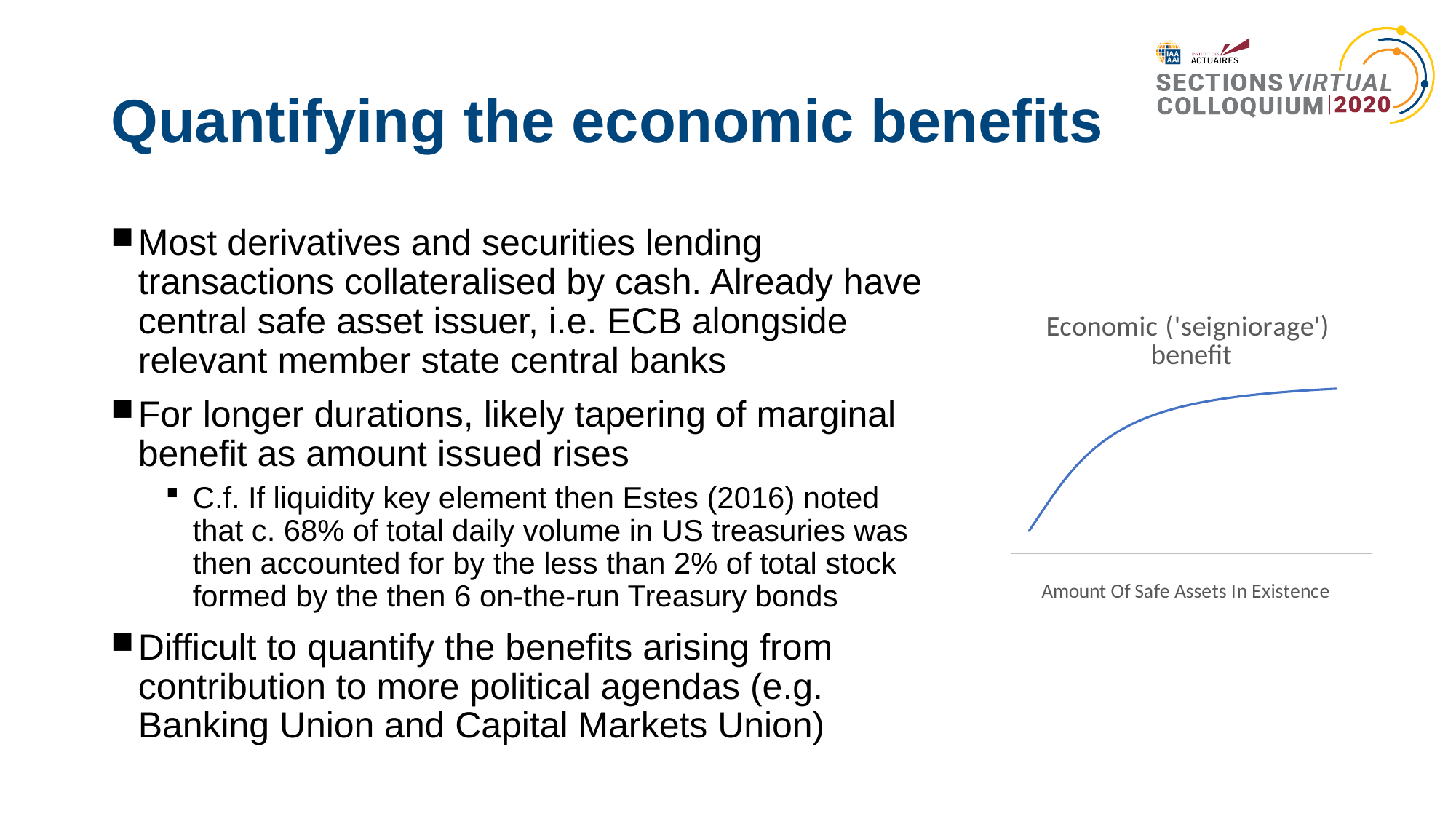
Does the plotted line rise or fall as the amount of safe assets in existence increases? rises How many lines are plotted on the chart? 1 Does the slope of the plotted line get steeper or flatter as you move to the right along the x axis? flatter What is the label on the horizontal axis of the chart? Amount Of Safe Assets In Existence What is the title of the chart? Economic ('seigniorage') benefit What kind of chart is shown on the slide? line chart